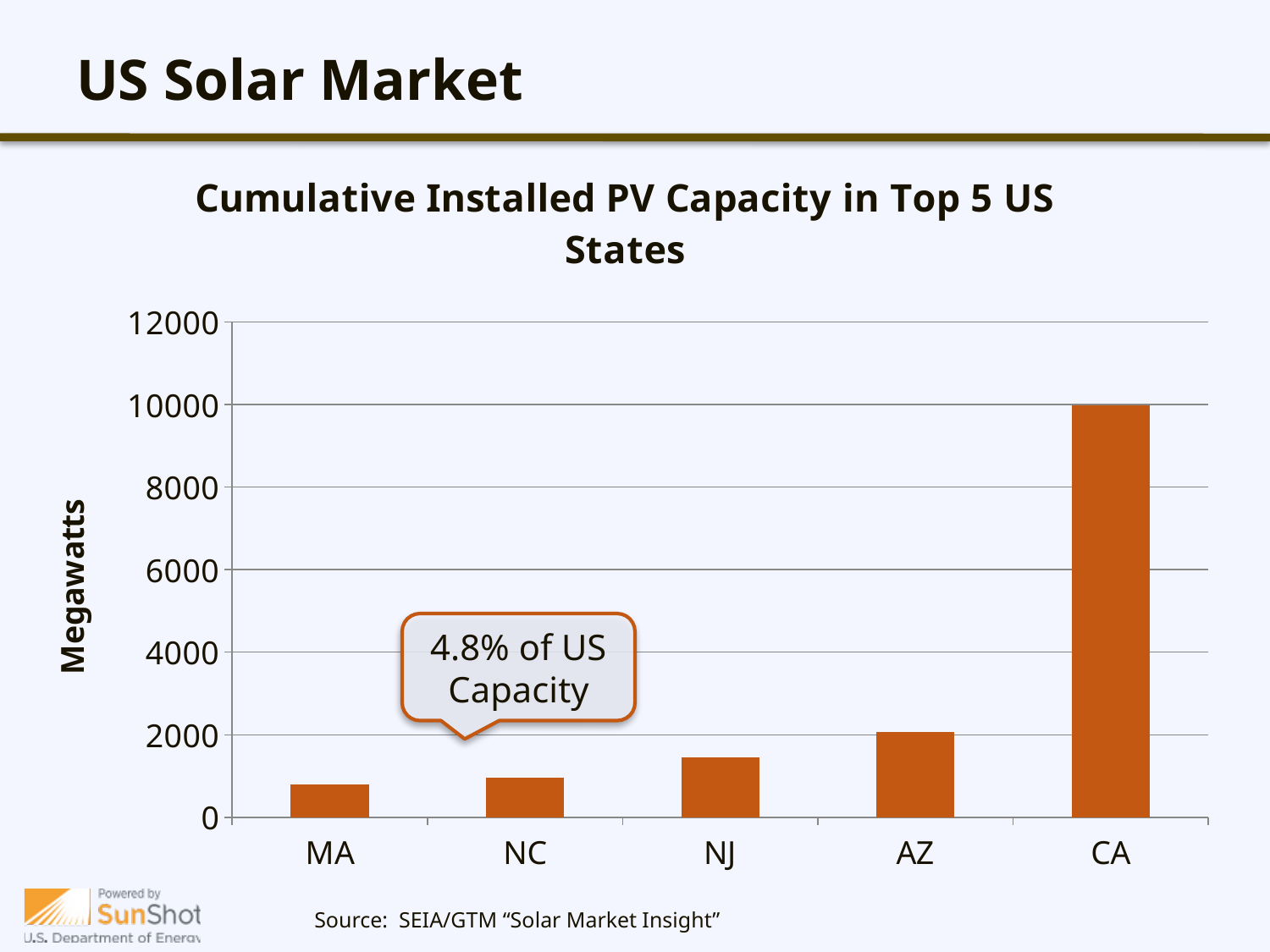
Which state has the highest cumulative installed PV capacity? CA What is the title of the chart? Cumulative Installed PV Capacity in Top 5 US States Is the value for MA greater or less than 2000? less Which state's bar does the callout "4.8% of US Capacity" point to? NC How many states are shown on the x axis of the chart? 5 Which has the larger installed PV capacity, CA or AZ? CA What kind of chart is shown on the slide? bar chart Is the value for NJ greater or less than 2000? less Which has the larger installed PV capacity, NJ or AZ? AZ Is the value for CA greater or less than 8000? greater Do the bar values rise or fall from left to right along the x axis? rise